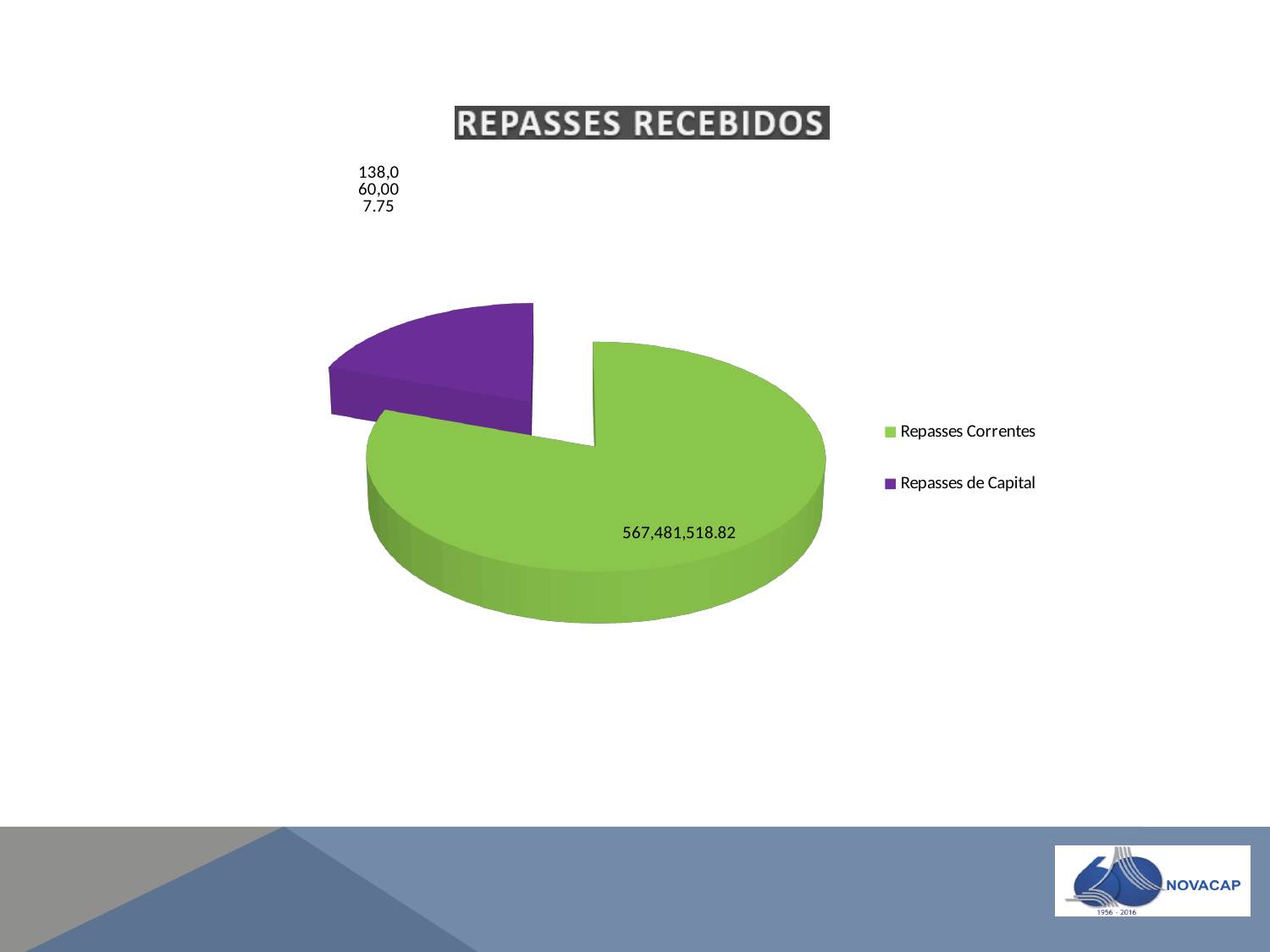
What kind of chart is shown on the slide? Pie chart What is the difference between Repasses Correntes and Repasses de Capital? 429,421,511.07 Which category has the smallest slice of the pie? Repasses de Capital What is the value for Repasses de Capital? 138,060,007.75 What is the total of the two slices in the pie chart? 705,541,526.57 What is the title of the chart? REPASSES RECEBIDOS What colour is the Repasses de Capital slice? Purple What is the value for Repasses Correntes? 567,481,518.82 Which category has the largest slice of the pie? Repasses Correntes Which is larger, Repasses Correntes or Repasses de Capital? Repasses Correntes How many slices does the pie chart have? 2 How many entries does the legend list? 2